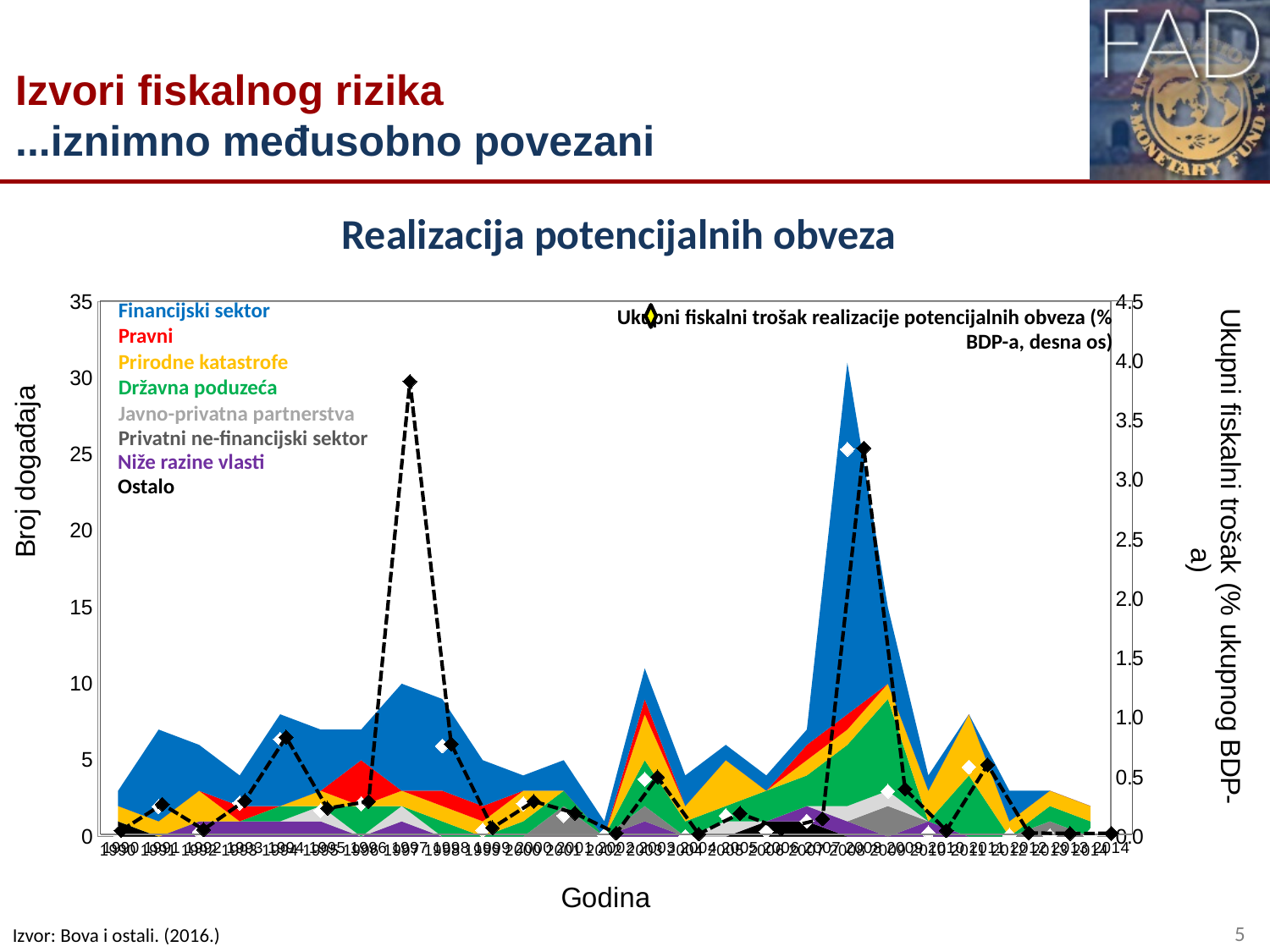
In which year does the total number of events (stacked area) reach its highest point? 2008 What kind of chart is shown on the slide? Stacked area chart with a line on a secondary axis What is the label of the left vertical axis? Broj događaja In which year does the dashed line for total fiscal cost (% of GDP) reach its highest value? 1997 Is the total number of events in 2002 greater or less than 5? less What is the title of the chart? Realizacija potencijalnih obveza How many categories of events are listed in the legend (excluding the dashed line series)? 8 How many years are plotted along the x axis? 25 Is the total fiscal cost (dashed line, right axis) in 1997 greater or less than 3.5? greater Which year has more total events, 2008 or 1997? 2008 Is the total number of events in 2008 greater or less than 25? greater Which year has a higher total fiscal cost on the dashed line, 1997 or 2008? 1997